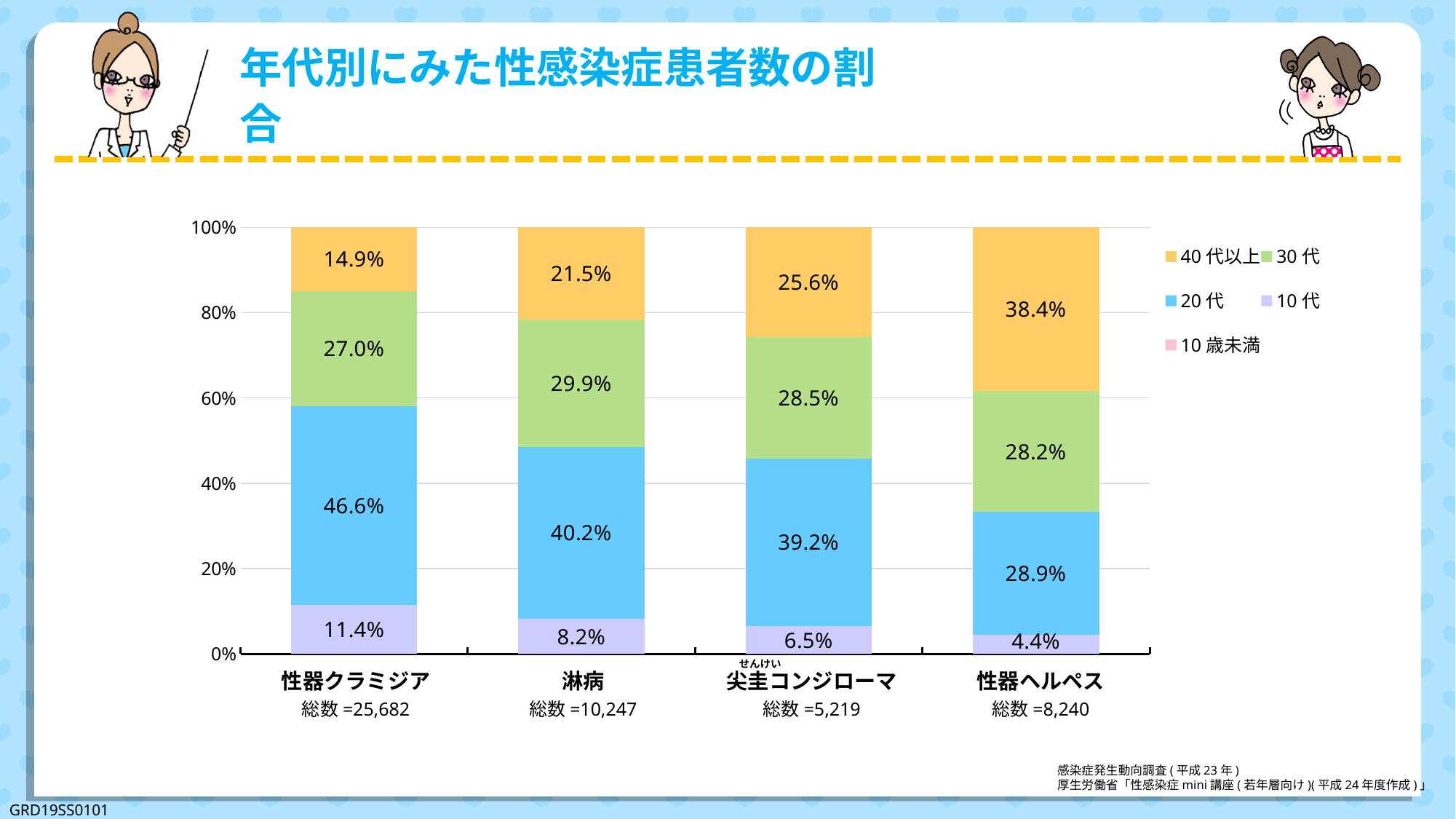
Which is larger: the 30代 share for 淋病 or the 30代 share for 性器クラミジア? 淋病 How many disease categories are plotted along the x axis? 4 What is the 20代 share for 性器クラミジア? 46.6% What is the difference between the 40代以上 share for 性器ヘルペス and for 性器クラミジア? 23.5% Which disease has the lowest 10代 share? 性器ヘルペス What is the 40代以上 share for 性器ヘルペス? 38.4% How many series does the legend list? 5 What is the total number (総数) shown for 淋病? 10,247 What is the 10代 share for 尖圭コンジローマ? 6.5% Which disease has the highest 20代 share? 性器クラミジア What is the 30代 share for 淋病? 29.9% What kind of chart is shown on the slide? stacked bar chart